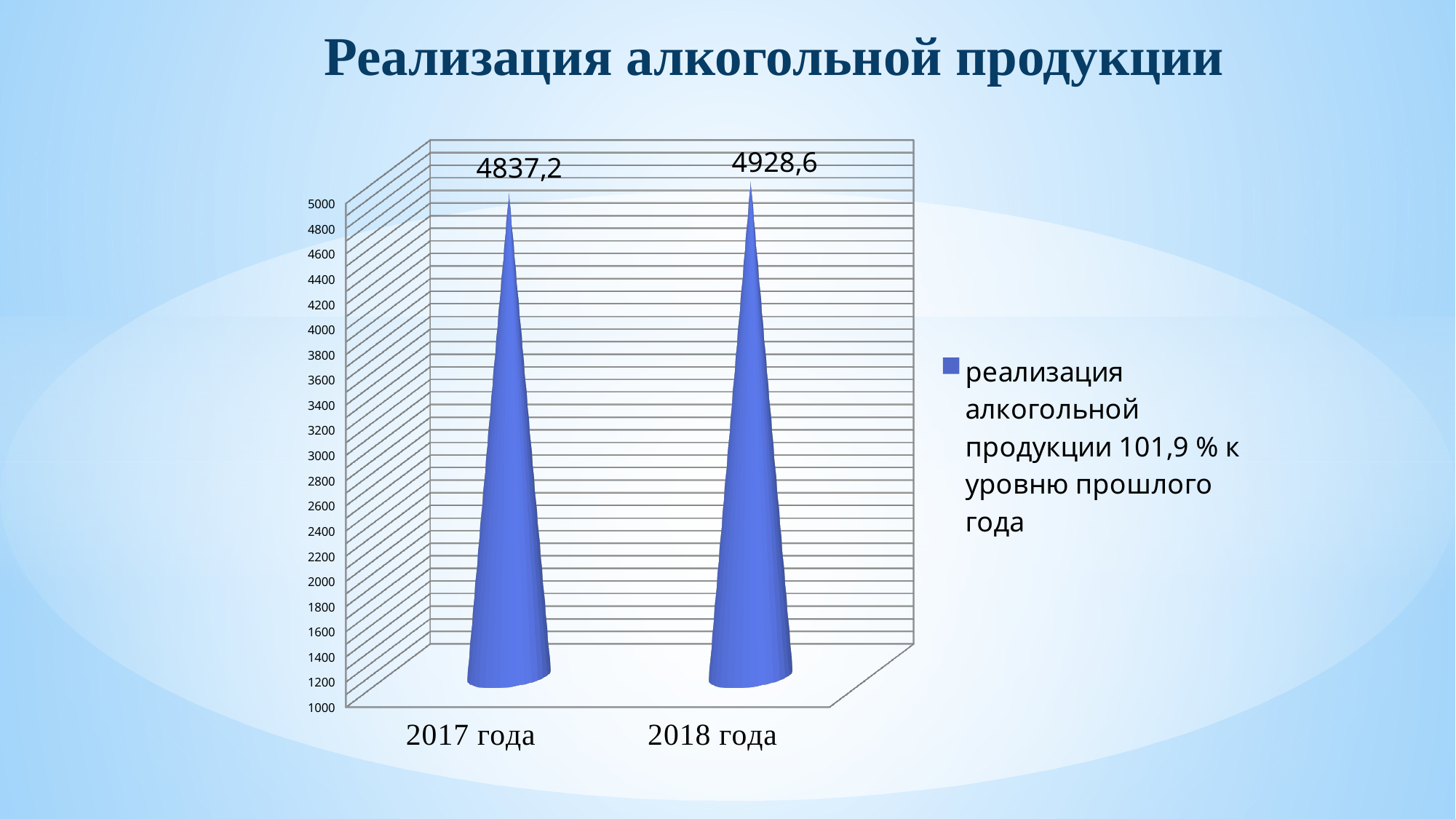
Is the value for 2017 года greater or less than 4000? greater What is the difference between the values for 2018 года and 2017 года? 91,4 Do the values rise or fall from 2017 года to 2018 года? rise How many series does the legend list? 1 Is the value for 2017 года larger or smaller than the value for 2018 года? smaller What is the value for 2018 года? 4928,6 What is the value for 2017 года? 4837,2 What kind of chart is shown on the slide? bar chart Which year has the lower value? 2017 года Which year has the higher value? 2018 года What is the title of the slide? Реализация алкогольной продукции How many categories are shown on the x axis? 2